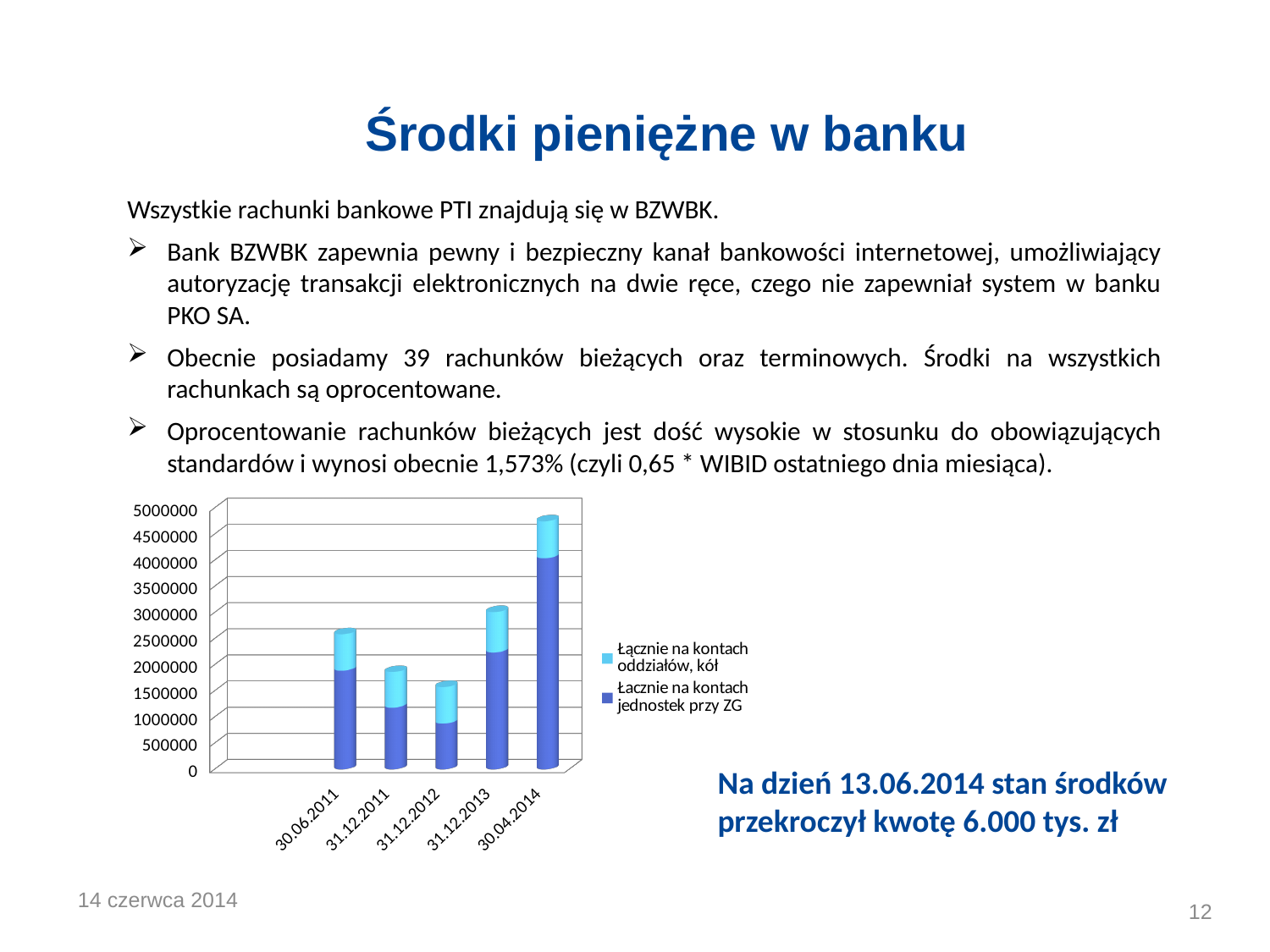
Do the total bars rise or fall from 31.12.2012 to 30.04.2014? rise Is the 'Łącznie na kontach jednostek przy ZG' value for 30.04.2014 greater or less than 3500000? greater Is the total bar for 31.12.2012 greater or less than 2000000? less Is the total bar for 30.04.2014 greater or less than 4500000? greater Which date has the lowest total bar in the chart? 31.12.2012 How many dates (categories) are shown on the x axis of the chart? 5 Which has the larger total bar, 30.06.2011 or 31.12.2011? 30.06.2011 What kind of chart is shown on the slide? stacked bar chart How many series does the chart legend list? 2 Which date has the highest total bar in the chart? 30.04.2014 Which series in the legend is shown in dark blue? Łącznie na kontach jednostek przy ZG